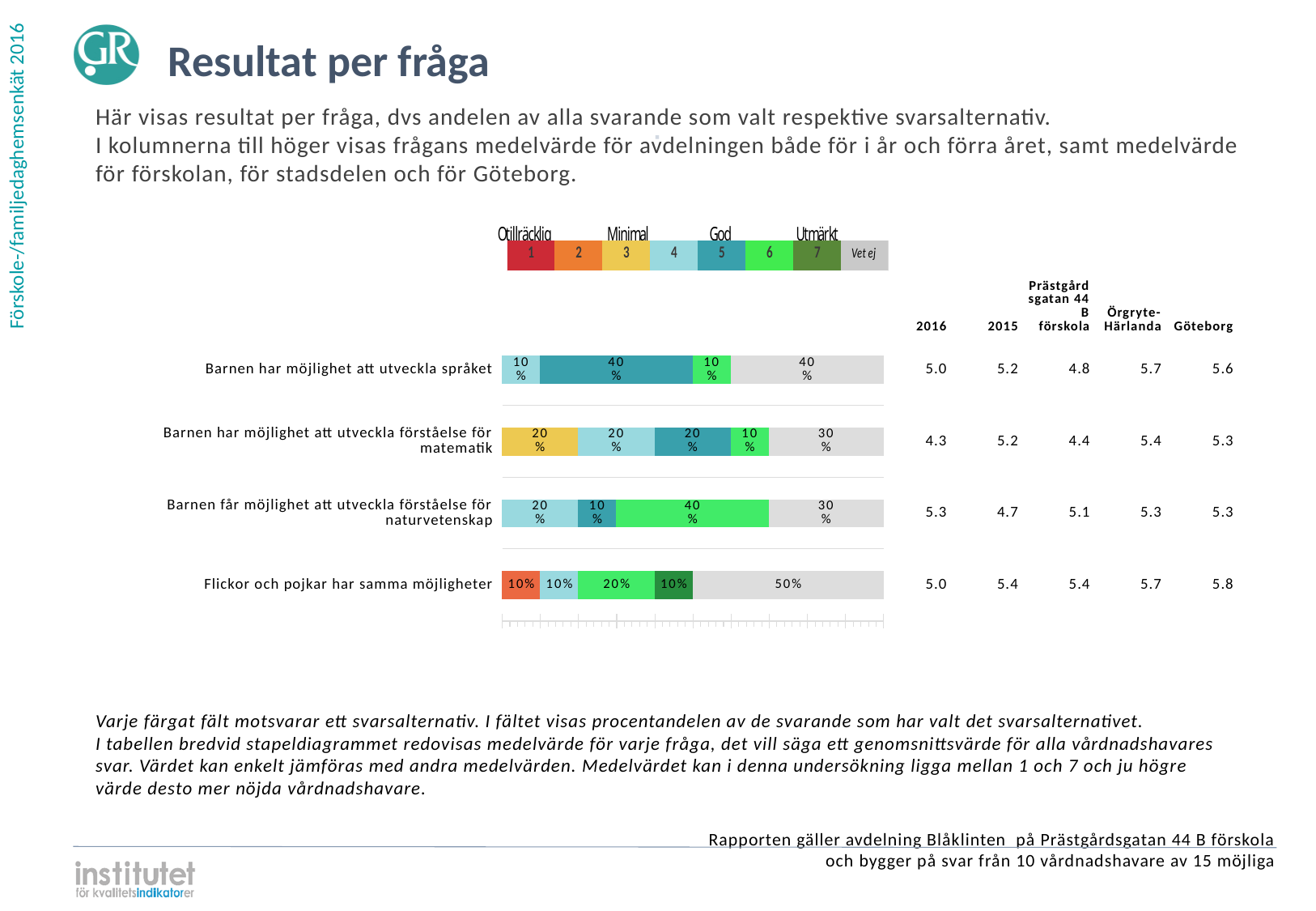
What percentage of respondents chose answer option 6 (green) for 'Barnen får möjlighet att utveckla förståelse för naturvetenskap'? 40% Which is larger: the option 3 (yellow) share for 'Barnen har möjlighet att utveckla förståelse för matematik' or the option 2 (orange) share for 'Flickor och pojkar har samma möjligheter'? Barnen har möjlighet att utveckla förståelse för matematik What is the difference between the 'Vet ej' share for 'Barnen har möjlighet att utveckla språket' and for 'Barnen har möjlighet att utveckla förståelse för matematik'? 10% How many answer options does the legend above the chart list, including 'Vet ej'? 8 What is the 2016 mean value shown for 'Barnen får möjlighet att utveckla förståelse för naturvetenskap'? 5.3 Which label in the legend corresponds to answer option 7? Utmärkt What percentage of respondents answered 'Vet ej' for 'Flickor och pojkar har samma möjligheter'? 50% Which question has the largest 'Vet ej' share? Flickor och pojkar har samma möjligheter What percentage of respondents chose answer option 5 (teal) for 'Barnen har möjlighet att utveckla språket'? 40% What kind of chart is used to show the results per question? Stacked bar chart How many questions (categories) are plotted in the bar chart? 4 What is the total of all segments in the bar for 'Barnen har möjlighet att utveckla förståelse för matematik'? 100%